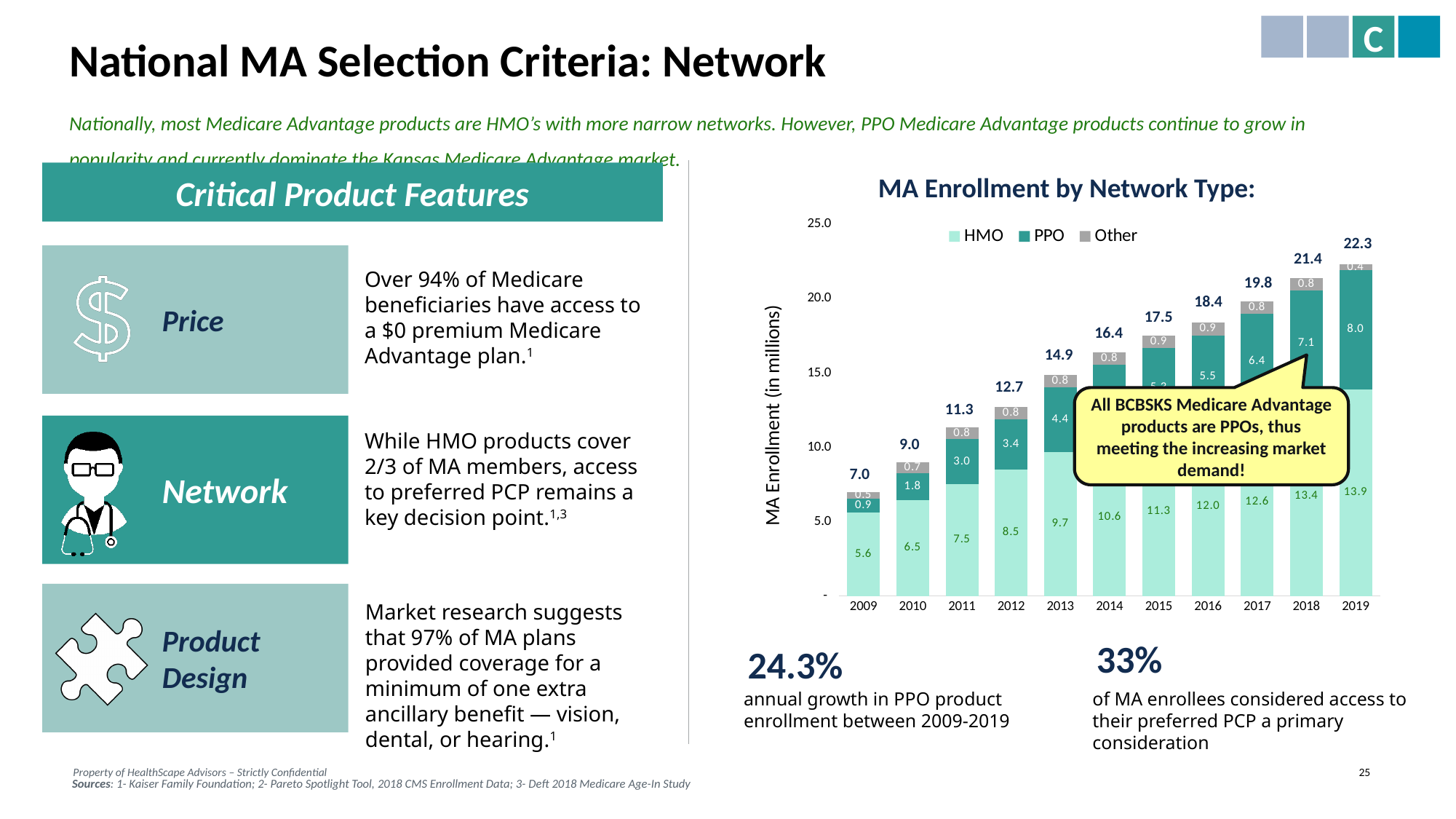
Which year has the lowest total MA enrollment? 2009 What is the HMO enrollment value shown for 2009? 5.6 What is the PPO enrollment value shown for 2018? 7.1 Does total MA enrollment rise or fall from 2009 to 2019? rise How many years are shown on the x axis of the MA Enrollment by Network Type chart? 11 What is the total MA enrollment (in millions) shown for 2019? 22.3 What is the Other enrollment value shown for 2019? 0.4 What type of chart is shown on the slide? stacked bar chart Which is larger in 2012, the HMO value or the PPO value? HMO How many series does the legend of the MA Enrollment by Network Type chart list? 3 What is the difference between the total MA enrollment in 2019 and in 2009? 15.3 Which year has the highest total MA enrollment? 2019